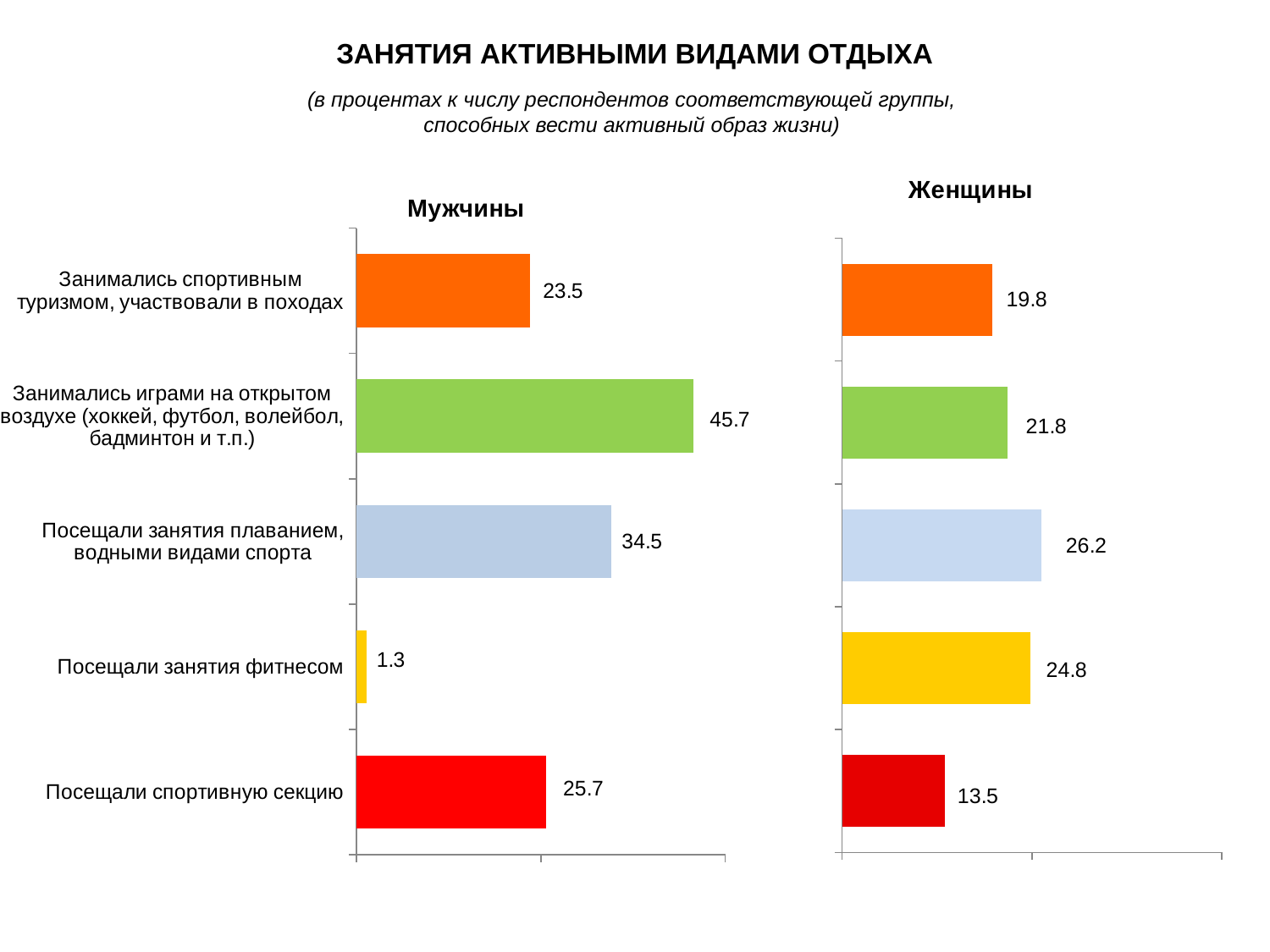
How many categories are shown in the "Мужчины" chart? 5 In the "Мужчины" chart, what colour is the bar for "Посещали спортивную секцию"? Red In the "Женщины" chart, which category has the lowest value? Посещали спортивную секцию Which is larger: the value for "Посещали занятия фитнесом" in the "Мужчины" chart or in the "Женщины" chart? Женщины In the "Мужчины" chart, what is the value for "Занимались играми на открытом воздухе (хоккей, футбол, волейбол, бадминтон и т.п.)"? 45.7 Which is larger: the value for "Посещали спортивную секцию" in the "Мужчины" chart or in the "Женщины" chart? Мужчины In the "Мужчины" chart, which category has the lowest value? Посещали занятия фитнесом In the "Женщины" chart, which category has the highest value? Посещали занятия плаванием, водными видами спорта What type of chart is the "Женщины" chart? Bar chart In the "Женщины" chart, what is the difference between "Посещали занятия плаванием, водными видами спорта" and "Посещали спортивную секцию"? 12.7 In the "Мужчины" chart, what is the difference between "Занимались играми на открытом воздухе" and "Посещали занятия плаванием, водными видами спорта"? 11.2 In the "Женщины" chart, what is the value for "Посещали занятия фитнесом"? 24.8